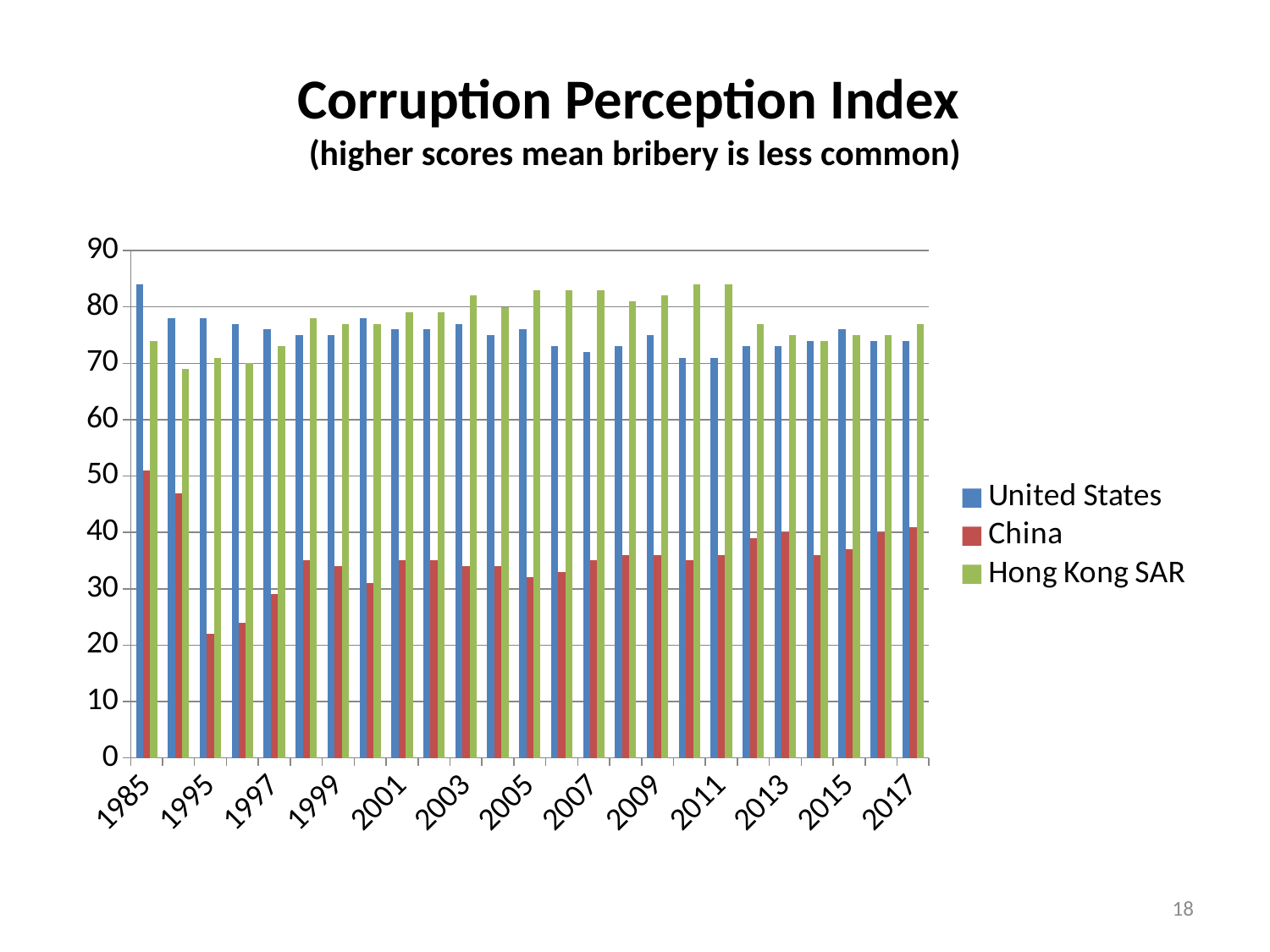
Which series has the lowest values across all years? China Is the value for China in 2005 greater or less than 30? greater Is the value for China in 1995 greater or less than 30? less What is the title of the chart? Corruption Perception Index In 2011, which is larger, the value for Hong Kong SAR or the value for the United States? Hong Kong SAR Is the value for the United States in 1985 greater or less than 80? greater In 1985, which is larger, the value for the United States or the value for China? United States Which series does the legend list first? United States How many series does the legend list? 3 What kind of chart is shown on the slide? bar chart In which year is the United States value highest? 1985